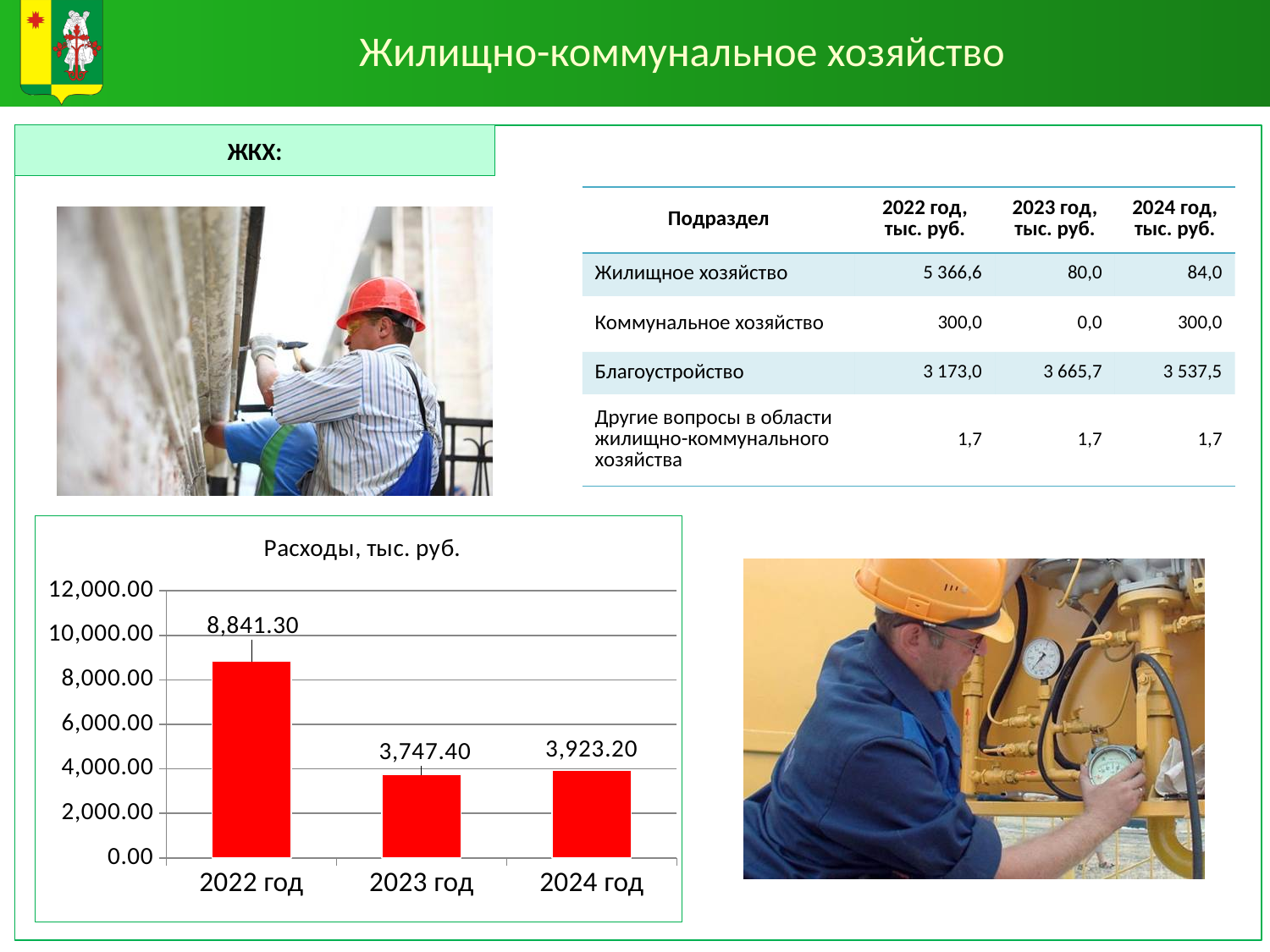
Which year has the lowest value in the chart 'Расходы, тыс. руб.'? 2023 год In the chart 'Расходы, тыс. руб.', which is larger: the value for 2023 год or 2024 год? 2024 год What is the value for 2023 год in the chart 'Расходы, тыс. руб.'? 3,747.40 What is the difference between the values for 2022 год and 2023 год in the chart 'Расходы, тыс. руб.'? 5,093.90 In the chart 'Расходы, тыс. руб.', is the value for 2022 год greater or less than 8,000.00? greater What is the value for 2024 год in the chart 'Расходы, тыс. руб.'? 3,923.20 Which year has the highest value in the chart 'Расходы, тыс. руб.'? 2022 год In the chart 'Расходы, тыс. руб.', does the value rise or fall from 2022 год to 2023 год? fall What is the value for 2022 год in the chart 'Расходы, тыс. руб.'? 8,841.30 What kind of chart is 'Расходы, тыс. руб.'? bar chart How many years are shown on the x axis of the chart 'Расходы, тыс. руб.'? 3 What is the difference between the values for 2024 год and 2023 год in the chart 'Расходы, тыс. руб.'? 175.80